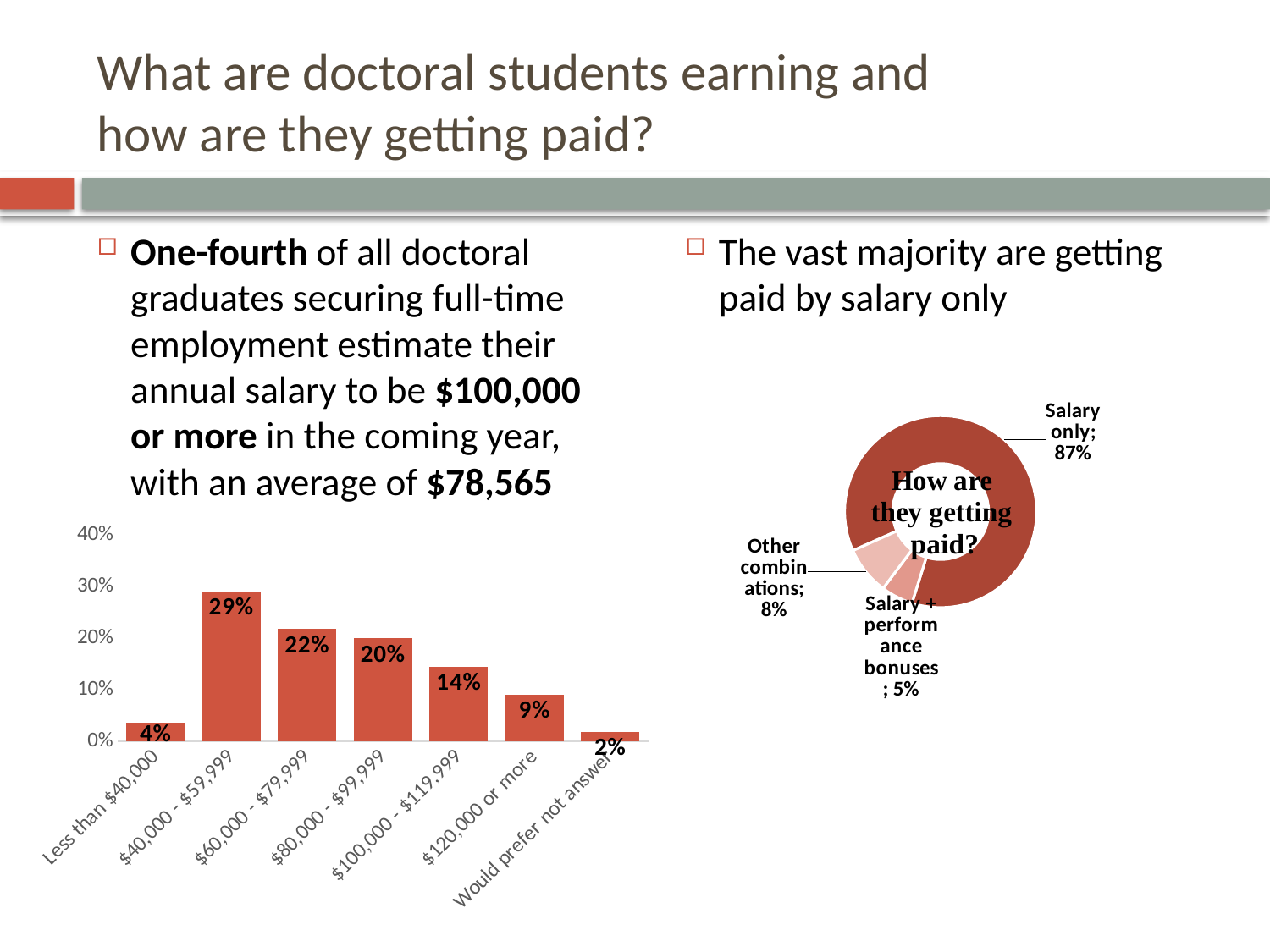
In the 'How are they getting paid?' chart, what is the value for Salary + performance bonuses? 5% In the bar chart on the left, which salary category has the highest value? $40,000 - $59,999 In the bar chart on the left, which is larger: the value for Less than $40,000 or the value for $100,000 - $119,999? $100,000 - $119,999 In the 'How are they getting paid?' chart, which category has the smallest share? Salary + performance bonuses How many salary categories are shown in the bar chart on the left? 7 In the bar chart on the left, what is the value for $120,000 or more? 9% What type of chart is the chart on the left of the slide? Bar chart In the bar chart on the left, what percentage of doctoral graduates estimate a salary of $40,000 - $59,999? 29% In the bar chart on the left, what is the difference between the values for $60,000 - $79,999 and $80,000 - $99,999? 2% In the 'How are they getting paid?' chart, what share are paid by salary only? 87% In the bar chart on the left, which category has the lowest value? Would prefer not answer What type of chart is the 'How are they getting paid?' chart? Doughnut chart